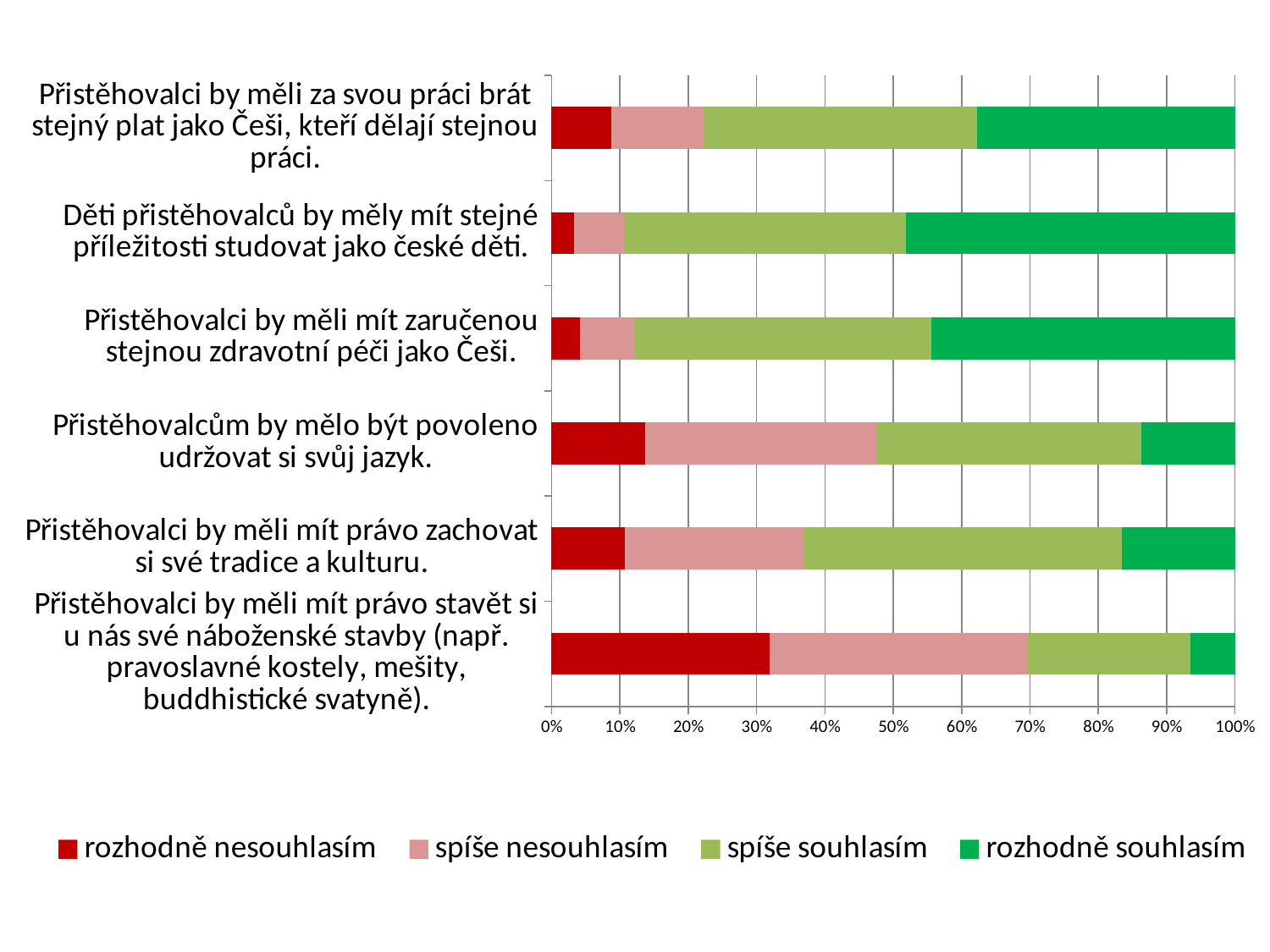
How many series does the legend list? 4 What kind of chart is shown on the slide? stacked bar chart Which has the larger 'spíše nesouhlasím' segment: the statement about udržovat si svůj jazyk or the statement about zachovat si své tradice a kulturu? Přistěhovalcům by mělo být povoleno udržovat si svůj jazyk. Is the 'rozhodně nesouhlasím' share for the statement 'Přistěhovalci by měli za svou práci brát stejný plat jako Češi...' greater or less than 20%? less What is the total of each stacked bar, as shown by the end of the x axis? 100% How many statements (categories) are plotted in the chart? 6 Where is the legend positioned relative to the chart? below the chart Which statement has the largest 'rozhodně nesouhlasím' segment? Přistěhovalci by měli mít právo stavět si u nás své náboženské stavby (např. pravoslavné kostely, mešity, buddhistické svatyně). Is the 'rozhodně nesouhlasím' share for the statement about náboženské stavby greater or less than 20%? greater Is the 'rozhodně souhlasím' share for the statement 'Přistěhovalcům by mělo být povoleno udržovat si svůj jazyk.' greater or less than 20%? less What colour represents 'rozhodně nesouhlasím' in the legend? dark red Which statement has the smallest 'rozhodně souhlasím' segment? Přistěhovalci by měli mít právo stavět si u nás své náboženské stavby (např. pravoslavné kostely, mešity, buddhistické svatyně).